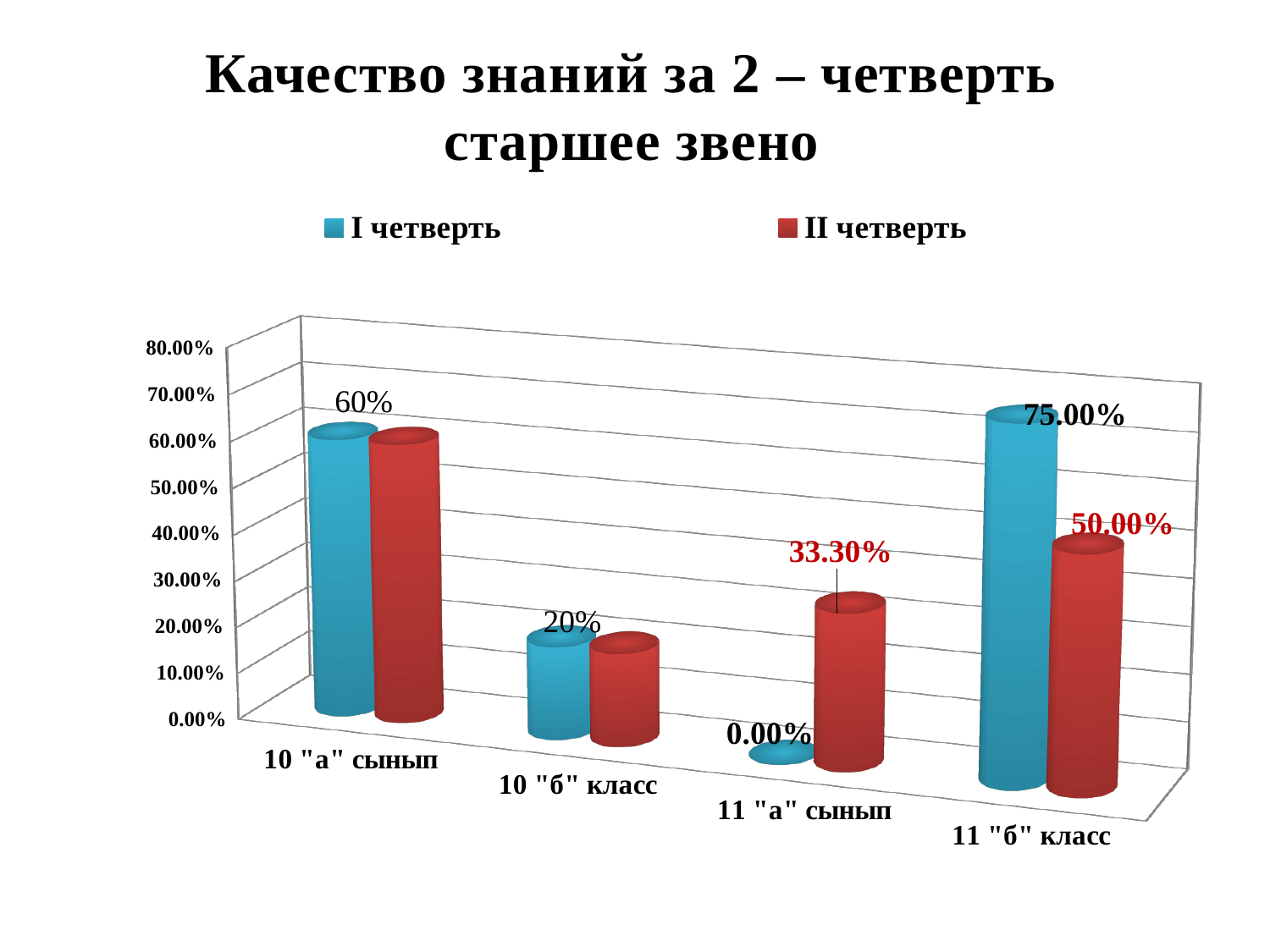
What is the difference between the I четверть and II четверть values for 11 "б" класс? 25.00% How many categories are shown on the x axis? 4 What is the value for 11 "б" класс in the I четверть series? 75.00% Which category has the highest I четверть value? 11 "б" класс Is the II четверть value for 10 "б" класс greater or less than 40.00%? less What kind of chart is shown on the slide? bar chart What is the value for 11 "а" сынып in the I четверть series? 0.00% What is the value for 11 "а" сынып in the II четверть series? 33.30% For 11 "а" сынып, which series has the larger value, I четверть or II четверть? II четверть Which category has the lowest I четверть value? 11 "а" сынып What is the value for 11 "б" класс in the II четверть series? 50.00% How many series does the legend list? 2